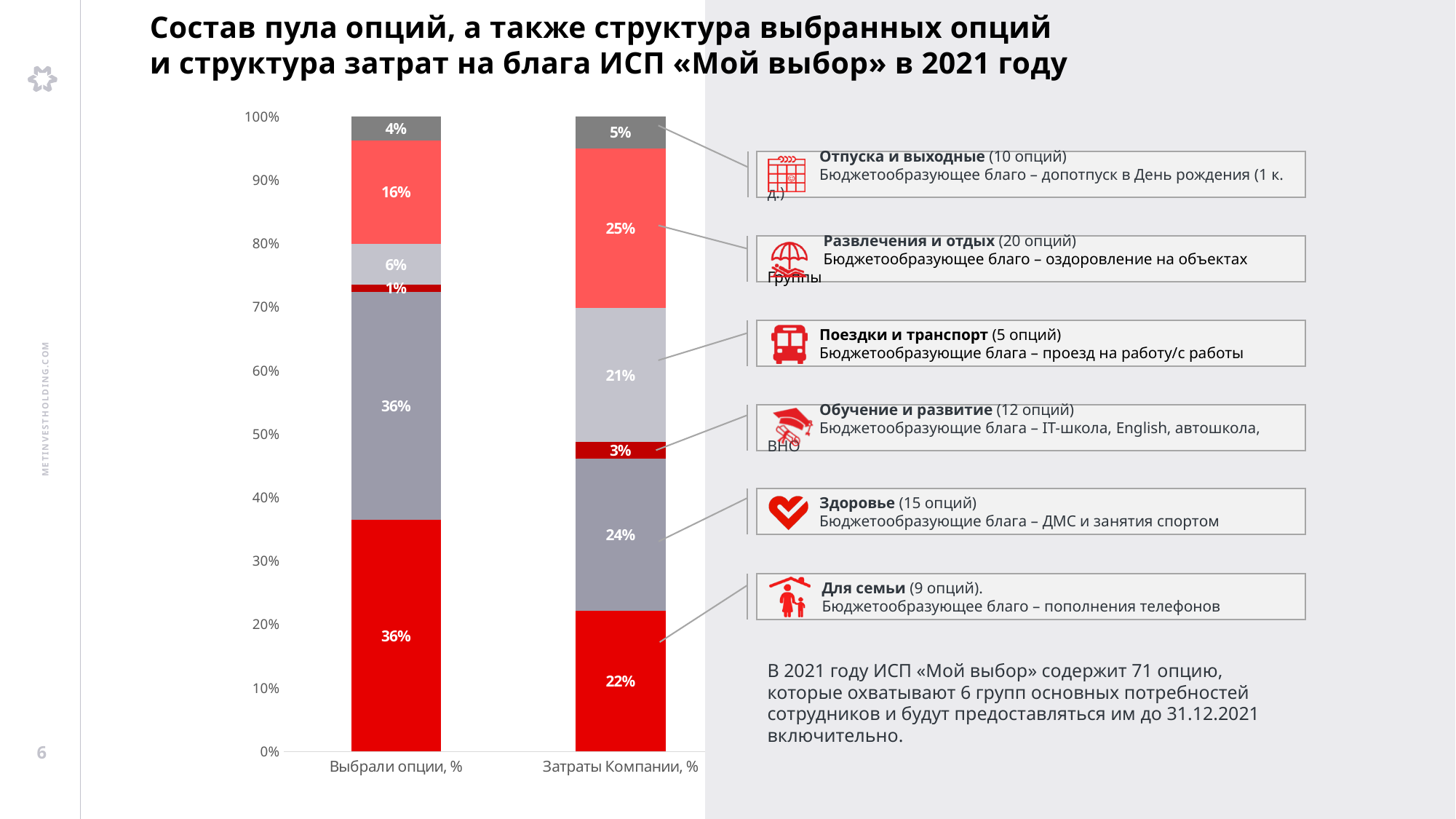
Which segment is the smallest in the "Выбрали опции, %" bar? 1% (Обучение и развитие) What kind of chart is shown on the slide? stacked bar chart What is the difference between the Здоровье segment in the "Выбрали опции, %" bar (36%) and in the "Затраты Компании, %" bar (24%)? 12% In the "Затраты Компании, %" bar, what is the value of the bottom red segment (Для семьи)? 22% In the "Затраты Компании, %" bar, what is the value of the segment for Поездки и транспорт? 21% In the "Выбрали опции, %" bar, what is the value of the top segment (Отпуска и выходные)? 4% Which segment is the largest in the "Затраты Компании, %" bar? 25% (Развлечения и отдых) What is the total of all segments in the "Затраты Компании, %" bar? 100% Is the Обучение и развитие segment larger in the "Выбрали опции, %" bar or in the "Затраты Компании, %" bar? Затраты Компании, % In the "Выбрали опции, %" bar, what is the value of the bottom red segment (Для семьи)? 36% How many bars (categories) are plotted on the x axis of the chart? 2 In the "Затраты Компании, %" bar, what is the value of the segment for Развлечения и отдых? 25%